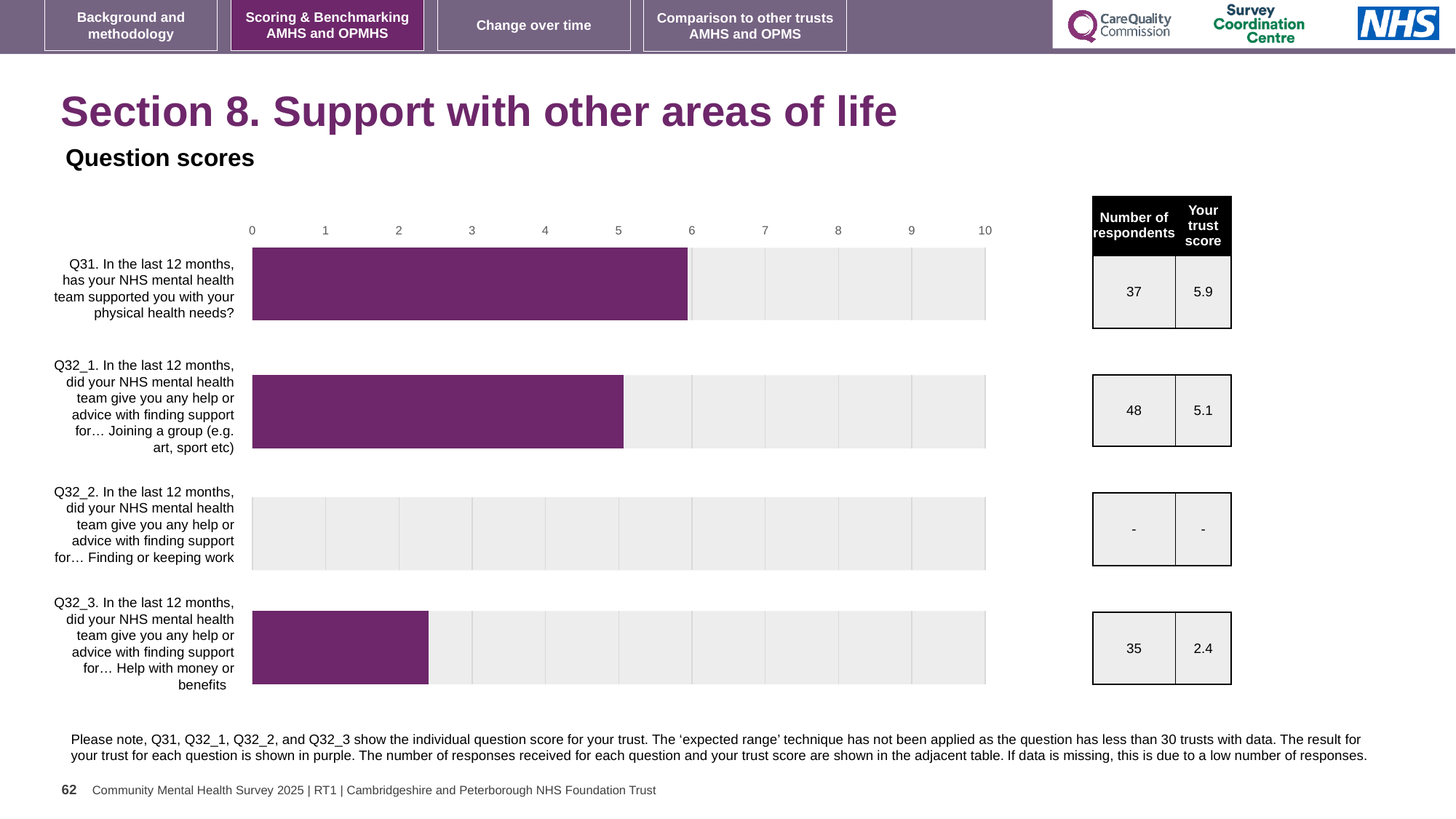
Is the trust score for Q32_1 greater or less than 6? less What is the trust score for Q31 (support with physical health needs)? 5.9 How many respondents answered Q32_1 (joining a group)? 48 What type of chart is shown on the slide? bar chart What is shown in the table for Q32_2 (finding or keeping work)? - Which has the larger trust score, Q32_1 or Q32_3? Q32_1 Which question has the highest trust score? Q31 What is the trust score for Q32_3 (help with money or benefits)? 2.4 Which question with a plotted bar has the lowest trust score? Q32_3 How many questions are listed on the chart? 4 What is the difference between the trust scores for Q31 and Q32_3? 3.5 What colour are the bars showing the trust's results? purple